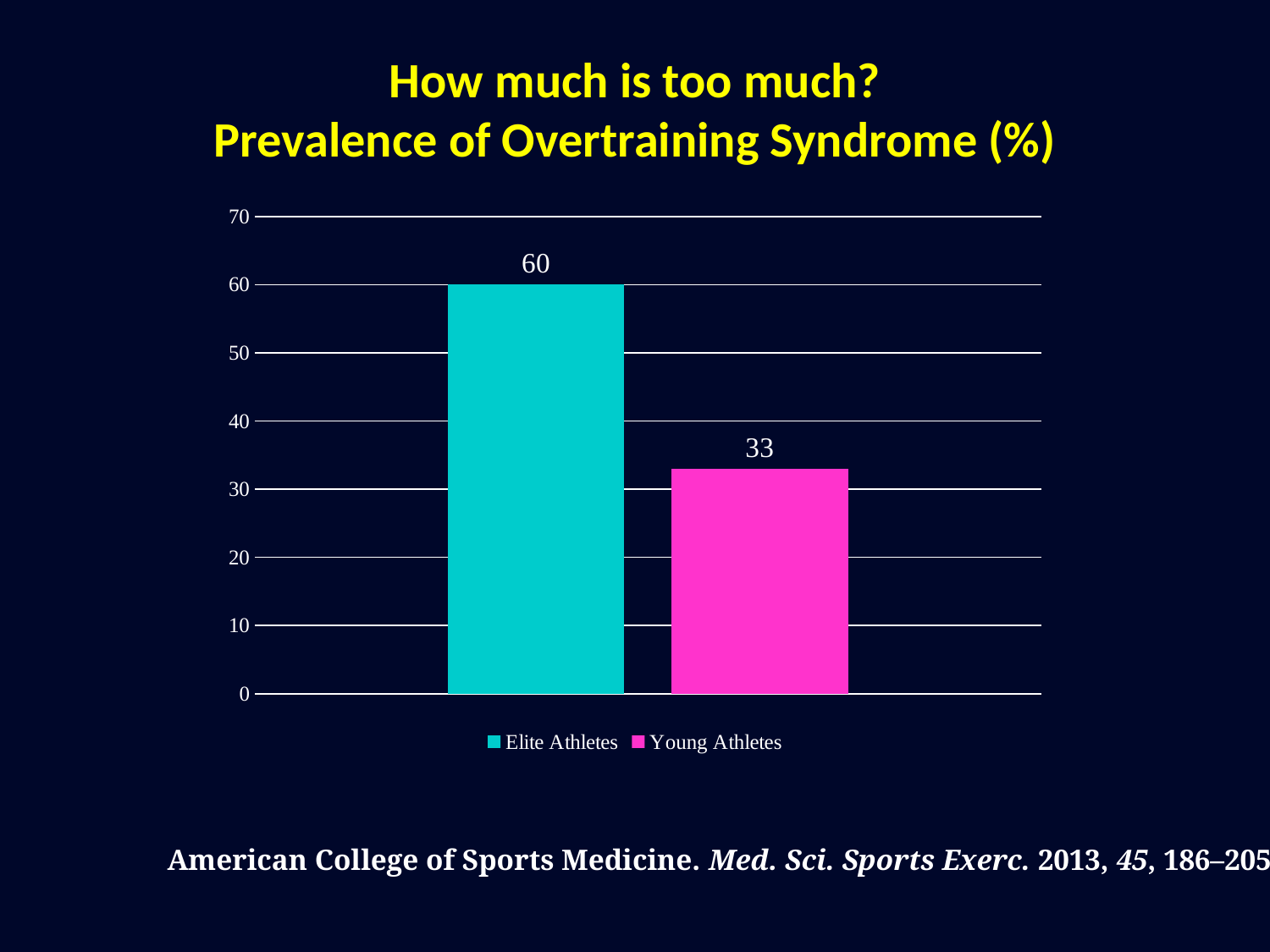
What is the value for Young Athletes? 33 What colour is the bar for Young Athletes? magenta Is the value for Elite Athletes greater or less than 50? greater Which series has the highest value? Elite Athletes Which is larger, the value for Elite Athletes or the value for Young Athletes? Elite Athletes How many bars are plotted in the chart? 2 What is the difference between the values for Elite Athletes and Young Athletes? 27 How many series does the legend list? 2 Which series has the lowest value? Young Athletes Is the value for Young Athletes greater or less than 40? less What is the value for Elite Athletes? 60 What kind of chart is shown on the slide? bar chart